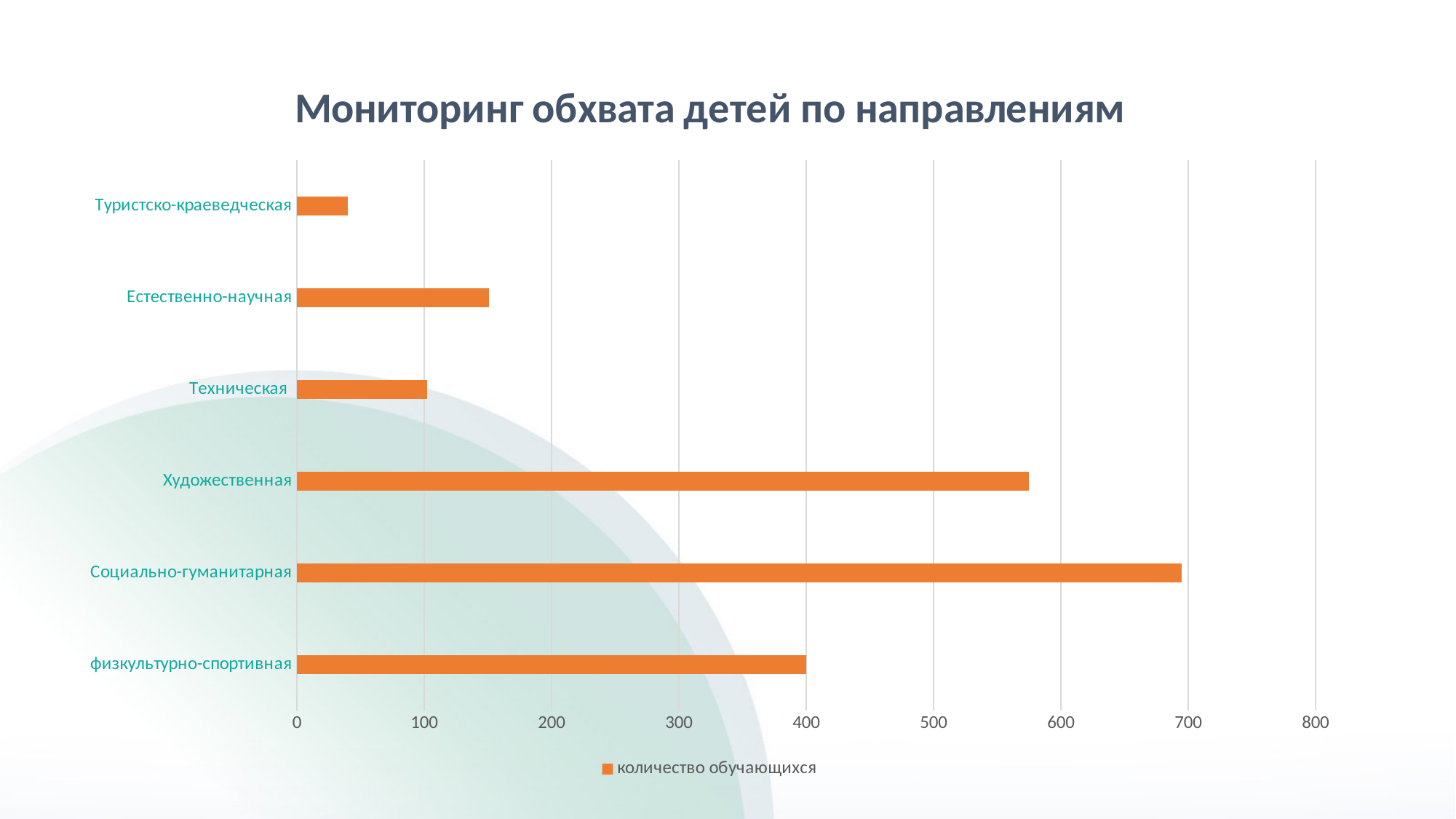
What is the title of the chart? Мониторинг обхвата детей по направлениям What type of chart is shown on the slide? Bar chart How many categories are shown in the chart? 6 Which category has the highest value? Социально-гуманитарная What is the name of the series in the legend? количество обучающихся Which is larger, the value for Художественная or the value for физкультурно-спортивная? Художественная Which category has the lowest value? Туристско-краеведческая Is the value for Туристско-краеведческая greater or less than 100? less Is the value for Художественная greater or less than 500? greater How many series does the legend list? 1 Is the value for Социально-гуманитарная greater or less than 600? greater